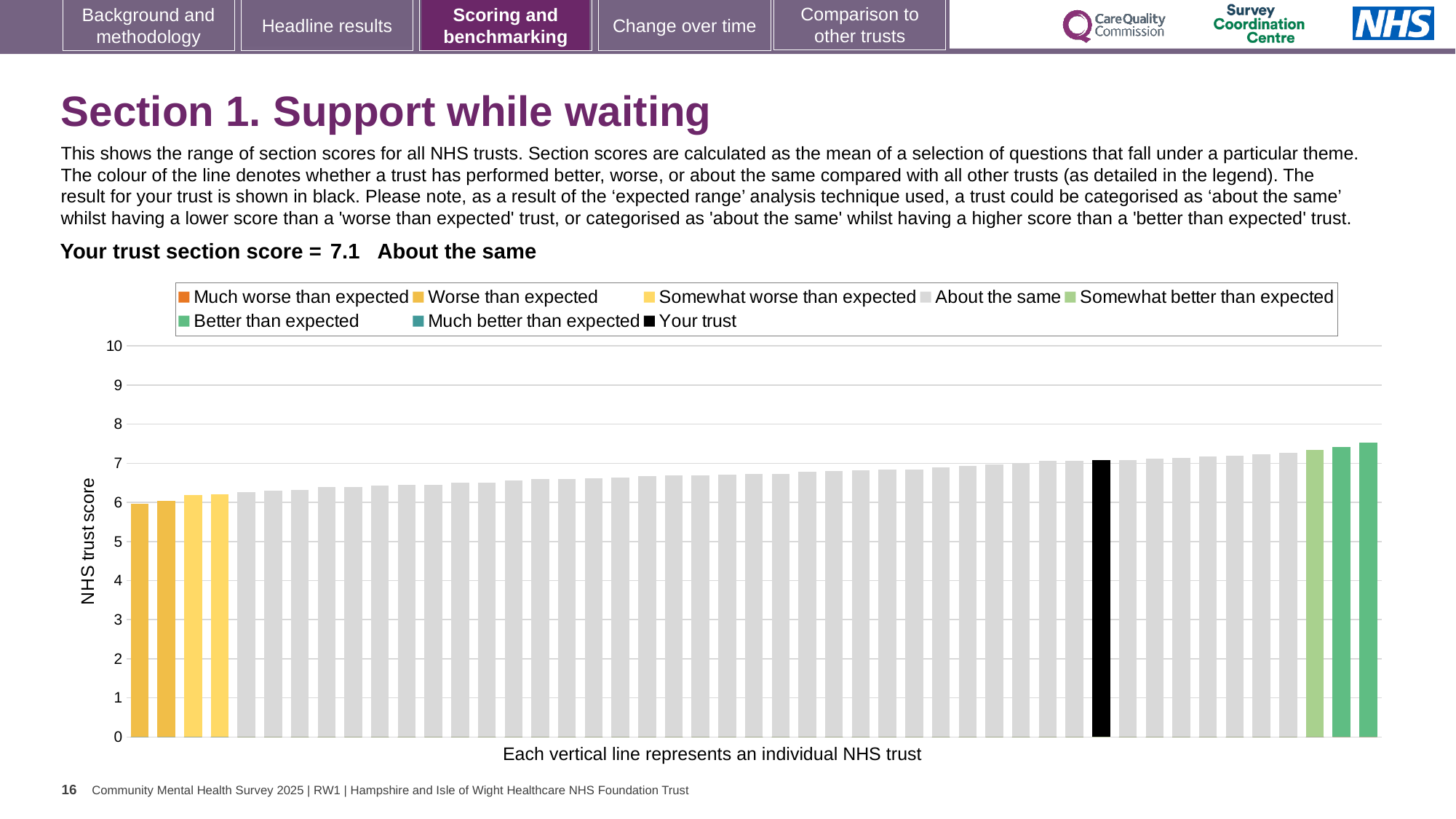
Is the value of the black bar for your trust greater or less than 6? greater How many entries does the chart legend list? 8 Which legend category does the highest bar on the chart belong to? Better than expected Do the bar values rise or fall from left to right along the x axis? Rise What is the label on the vertical axis of the chart? NHS trust score How many bars are coloured as 'Better than expected' (green) on the chart? 2 Is the value of the lowest bar on the chart greater or less than 7? less What kind of chart is shown on the slide? Bar chart What is the section score for your trust shown on the slide? 7.1 Which legend category does the lowest bar on the chart belong to? Worse than expected Which performance category is your trust placed in for this section? About the same Is the value of the highest bar on the chart greater or less than 8? less